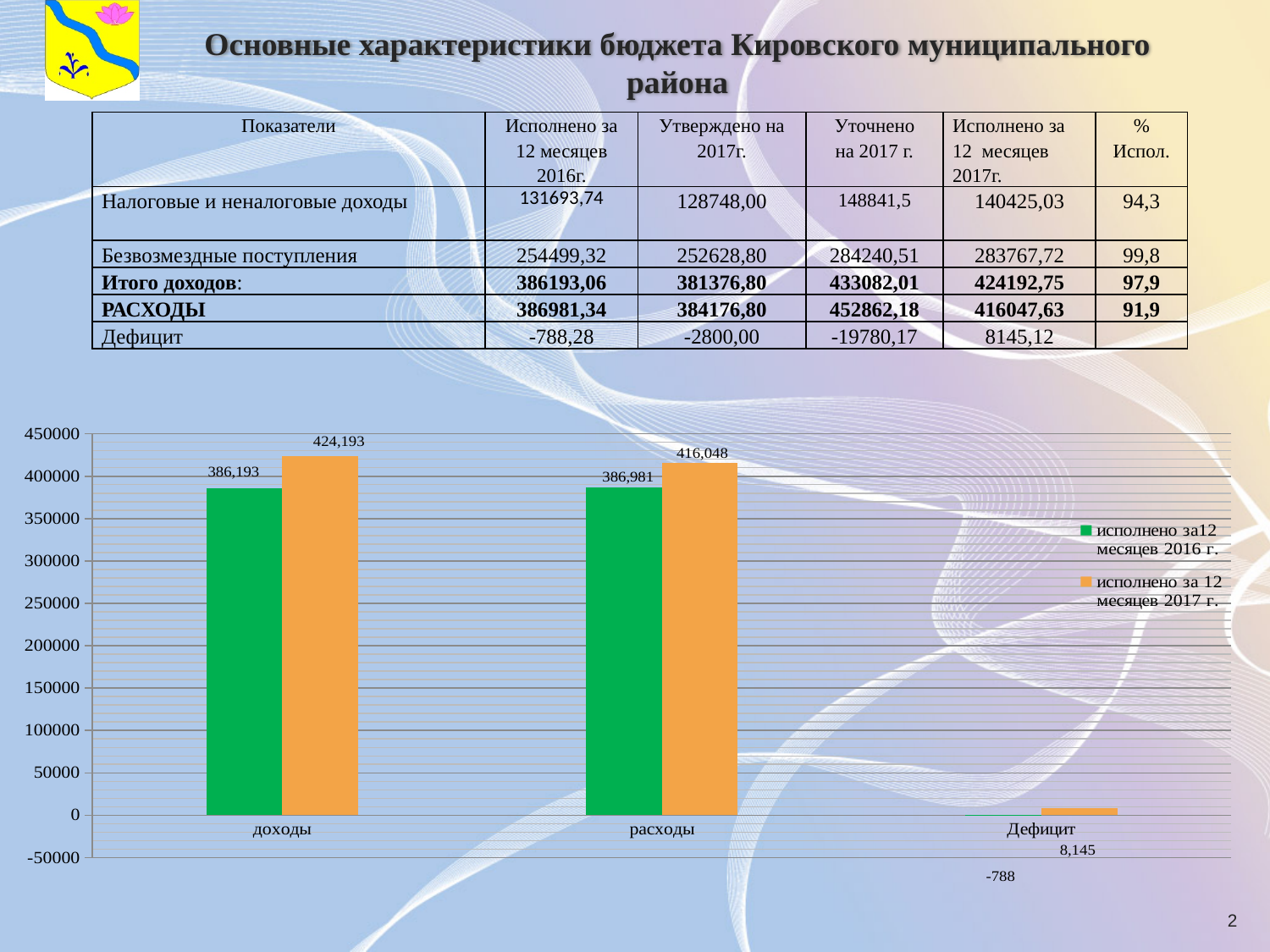
What is the difference between the 2017 and 2016 values for доходы? 38,000 What is the value for Дефицит in the series исполнено за 12 месяцев 2017 г.? 8,145 How many series does the chart legend list? 2 Which is larger for расходы: the value for исполнено за12 месяцев 2016 г. or for исполнено за 12 месяцев 2017 г.? исполнено за 12 месяцев 2017 г. Which category has the lowest value in the series исполнено за 12 месяцев 2017 г.? Дефицит Which category has the highest value in the series исполнено за 12 месяцев 2017 г.? доходы What is the value for Дефицит in the series исполнено за12 месяцев 2016 г.? -788 What is the value for доходы in the series исполнено за 12 месяцев 2017 г.? 424,193 Which colour represents the series исполнено за 12 месяцев 2017 г. in the chart? orange How many categories are shown on the x axis of the chart? 3 What kind of chart is shown on the slide? bar chart What is the value for расходы in the series исполнено за12 месяцев 2016 г.? 386,981